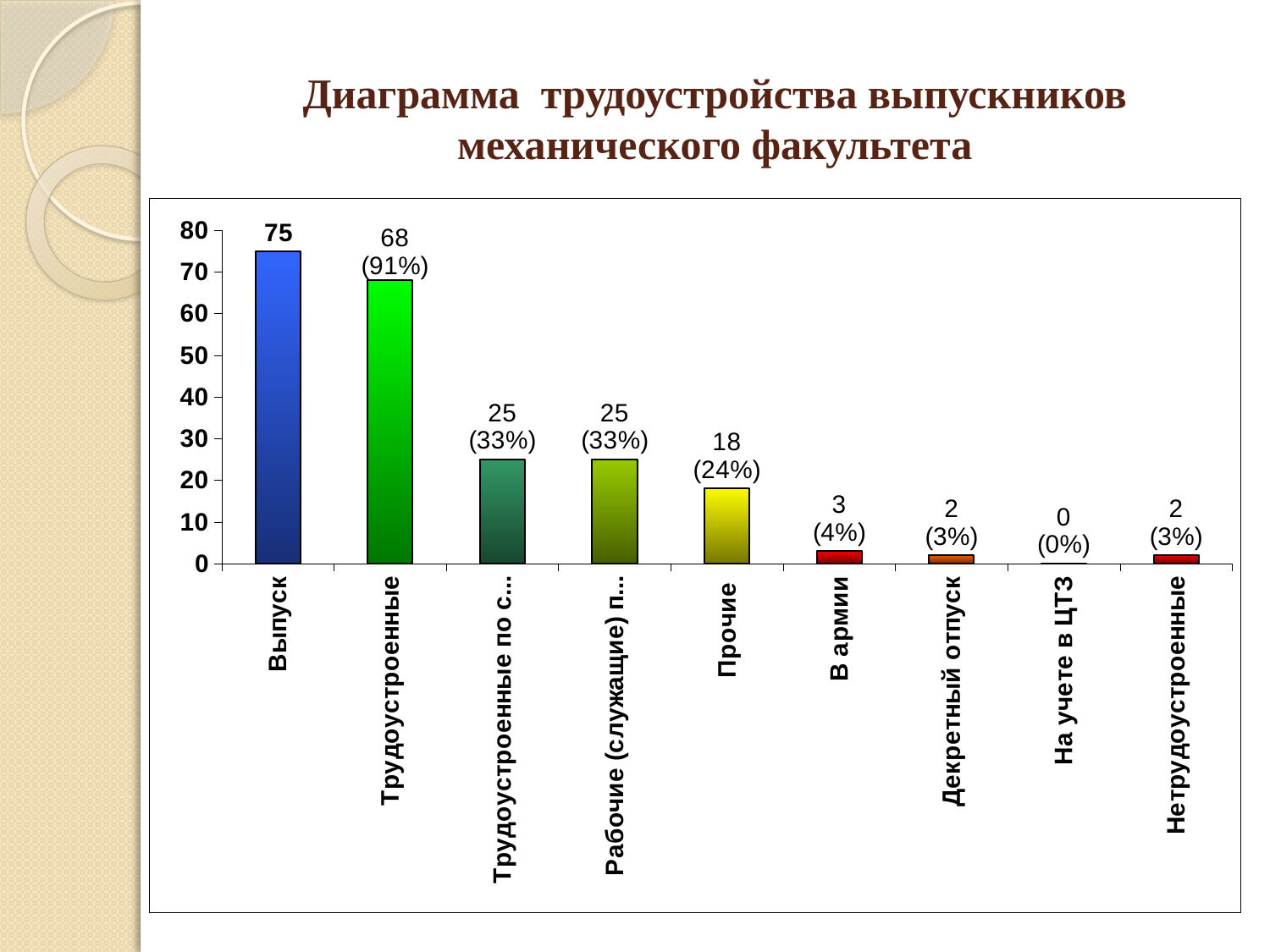
What is the difference between the values for Выпуск and Трудоустроенные? 7 What is the value of the bar for Выпуск? 75 What is the value of the bar for Трудоустроенные? 68 What is the difference between the values for Трудоустроенные and Прочие? 50 Which category has the lowest value? На учете в ЦТЗ What is the value of the bar for Прочие? 18 What type of chart is shown on the slide? Bar chart What is the value of the bar for В армии? 3 What is the value of the bar for Декретный отпуск? 2 How many categories are shown on the x axis? 9 Which is larger, the value for Прочие or the value for В армии? Прочие Which category has the highest bar? Выпуск